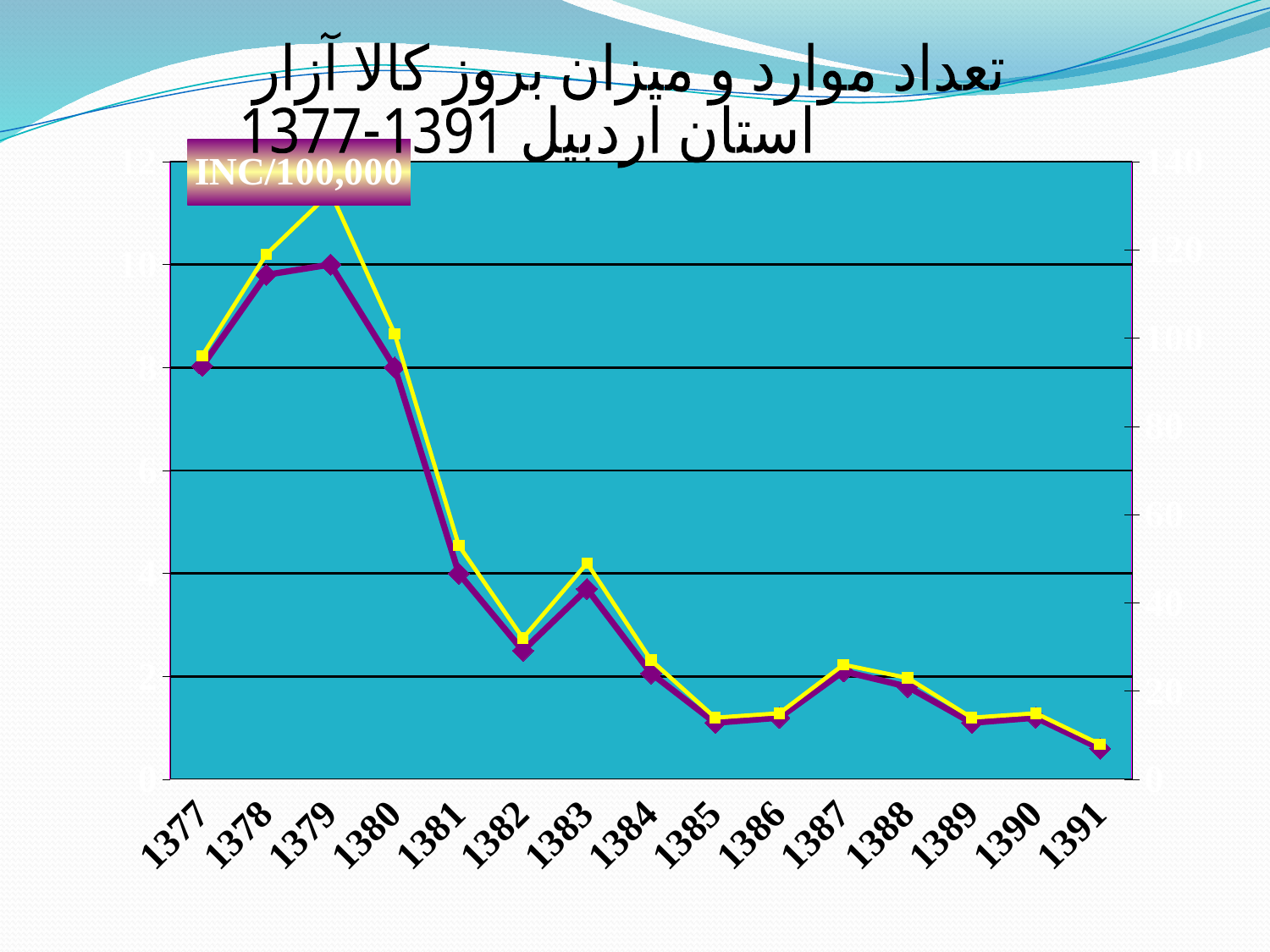
How many years are plotted along the x axis? 15 Is the value of the yellow line at 1379 greater or less than 120 on the right axis? greater What text appears in the label box at the top left of the plot area? INC/100,000 Do the values generally rise or fall from 1379 to 1391? fall What kind of chart is shown on the slide? line chart Is the value of the purple line at 1391 greater or less than 2 on the left axis? less Is the value of the purple line at 1379 greater or less than 8 on the left axis? greater Which year has the larger value on the yellow line, 1383 or 1385? 1383 How many lines are plotted on the chart? 2 In which year does the purple line reach its lowest point? 1391 Which year has the larger value on the purple line, 1379 or 1391? 1379 In which year does the yellow line reach its highest point? 1379